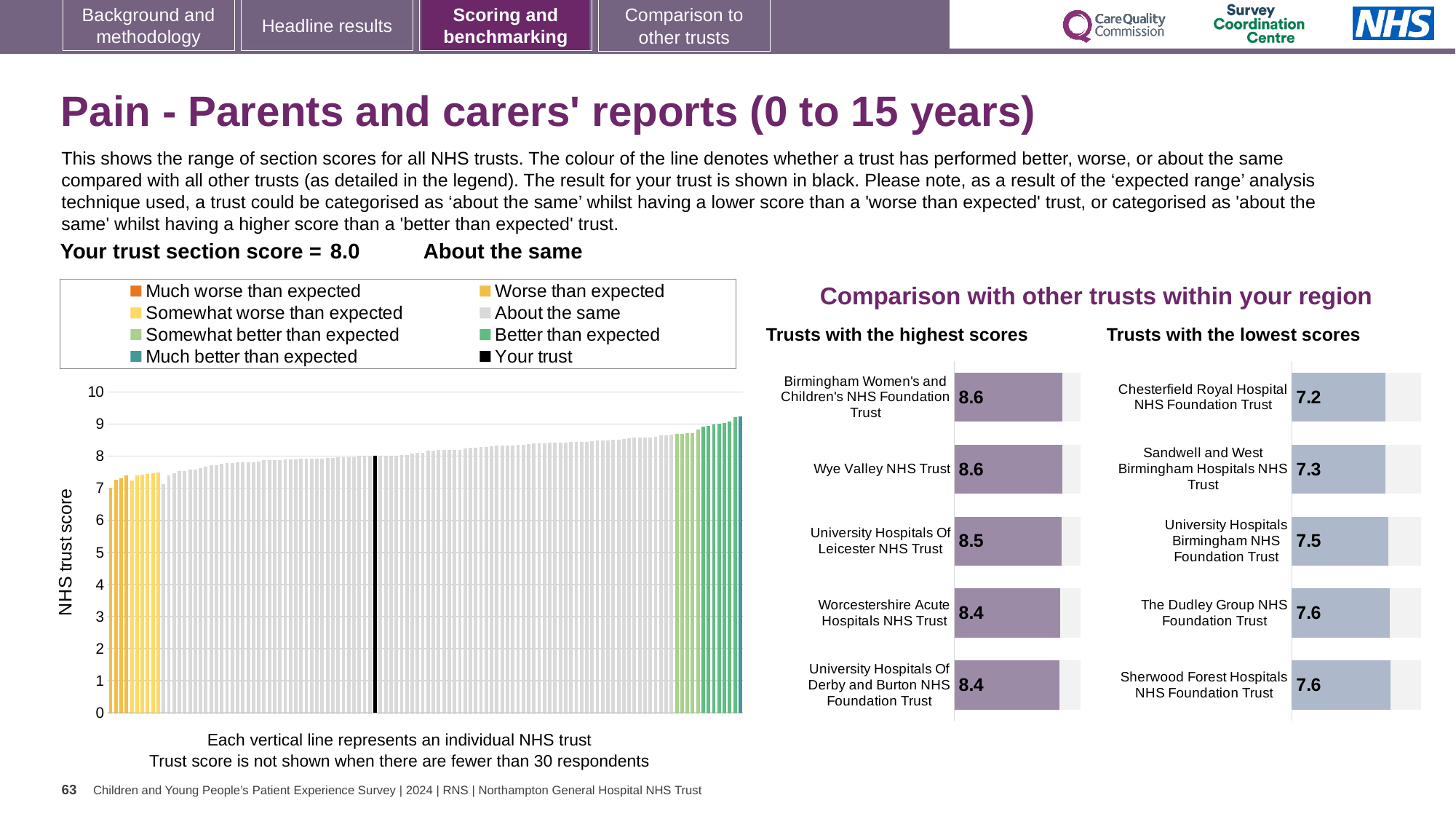
How many entries does the legend of the large chart on the left list? 8 What kind of chart is the large chart on the left showing NHS trust scores? bar chart In the 'Trusts with the lowest scores' chart, which has the larger score: Sandwell and West Birmingham Hospitals NHS Trust or University Hospitals Birmingham NHS Foundation Trust? University Hospitals Birmingham NHS Foundation Trust In the large chart on the left, do the trust scores rise or fall from left to right along the x axis? rise In the 'Trusts with the lowest scores' chart, which trust has the lowest score? Chesterfield Royal Hospital NHS Foundation Trust In the 'Trusts with the lowest scores' chart, what is the difference between the scores of The Dudley Group NHS Foundation Trust and Chesterfield Royal Hospital NHS Foundation Trust? 0.4 In the large chart on the left, is the value of the rightmost bar greater or less than 8? greater In the 'Trusts with the highest scores' chart, what is the score for University Hospitals Of Leicester NHS Trust? 8.5 In the 'Trusts with the highest scores' chart, how many trusts are shown? 5 In the 'Trusts with the highest scores' chart, what is the difference between the scores of University Hospitals Of Leicester NHS Trust and Worcestershire Acute Hospitals NHS Trust? 0.1 In the large chart on the left, what is the section score for Your trust? 8.0 What is the y-axis label of the large chart on the left? NHS trust score